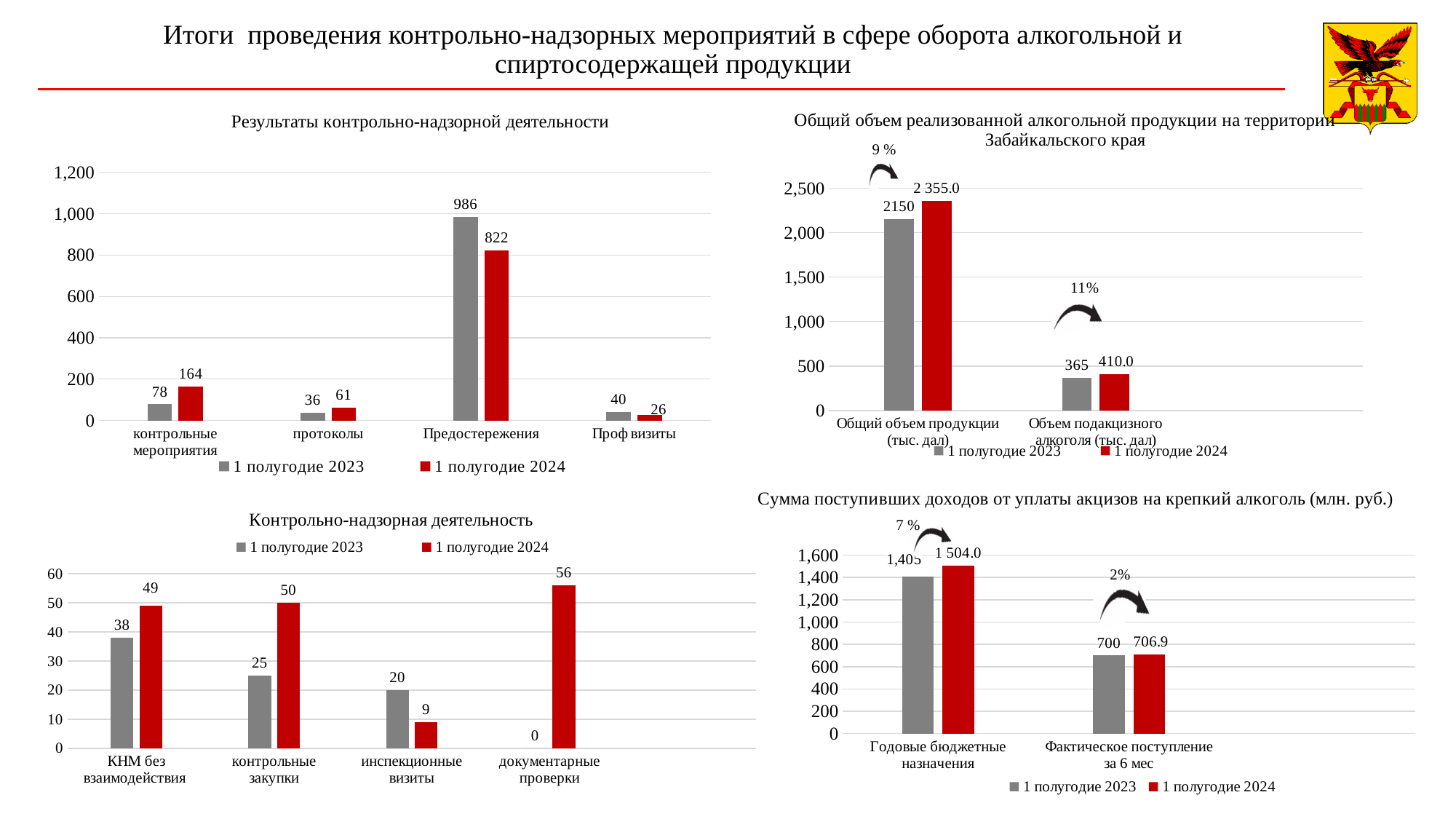
In the chart 'Результаты контрольно-надзорной деятельности', what is the value for Предостережения in 1 полугодие 2024? 822 In the chart 'Результаты контрольно-надзорной деятельности', how many categories are shown on the x axis? 4 In the chart 'Результаты контрольно-надзорной деятельности', which category has the highest value for 1 полугодие 2023? Предостережения In the chart 'Результаты контрольно-надзорной деятельности', what is the difference between the 1 полугодие 2024 and 1 полугодие 2023 values for контрольные мероприятия? 86 In the chart 'Общий объем реализованной алкогольной продукции на территории Забайкальского края', what is the value for Объем подакцизного алкоголя (тыс. дал) in 1 полугодие 2023? 365 What type of chart is 'Контрольно-надзорная деятельность'? bar chart In the chart 'Сумма поступивших доходов от уплаты акцизов на крепкий алкоголь (млн. руб.)', how many series does the legend list? 2 In the chart 'Контрольно-надзорная деятельность', which is larger for инспекционные визиты: 1 полугодие 2023 or 1 полугодие 2024? 1 полугодие 2023 In the chart 'Общий объем реализованной алкогольной продукции на территории Забайкальского края', what is the value for Общий объем продукции (тыс. дал) in 1 полугодие 2024? 2 355.0 In the chart 'Контрольно-надзорная деятельность', which category has the lowest value for 1 полугодие 2023? документарные проверки In the chart 'Контрольно-надзорная деятельность', what is the value for контрольные закупки in 1 полугодие 2024? 50 In the chart 'Сумма поступивших доходов от уплаты акцизов на крепкий алкоголь (млн. руб.)', what is the value for Фактическое поступление за 6 мес in 1 полугодие 2024? 706.9